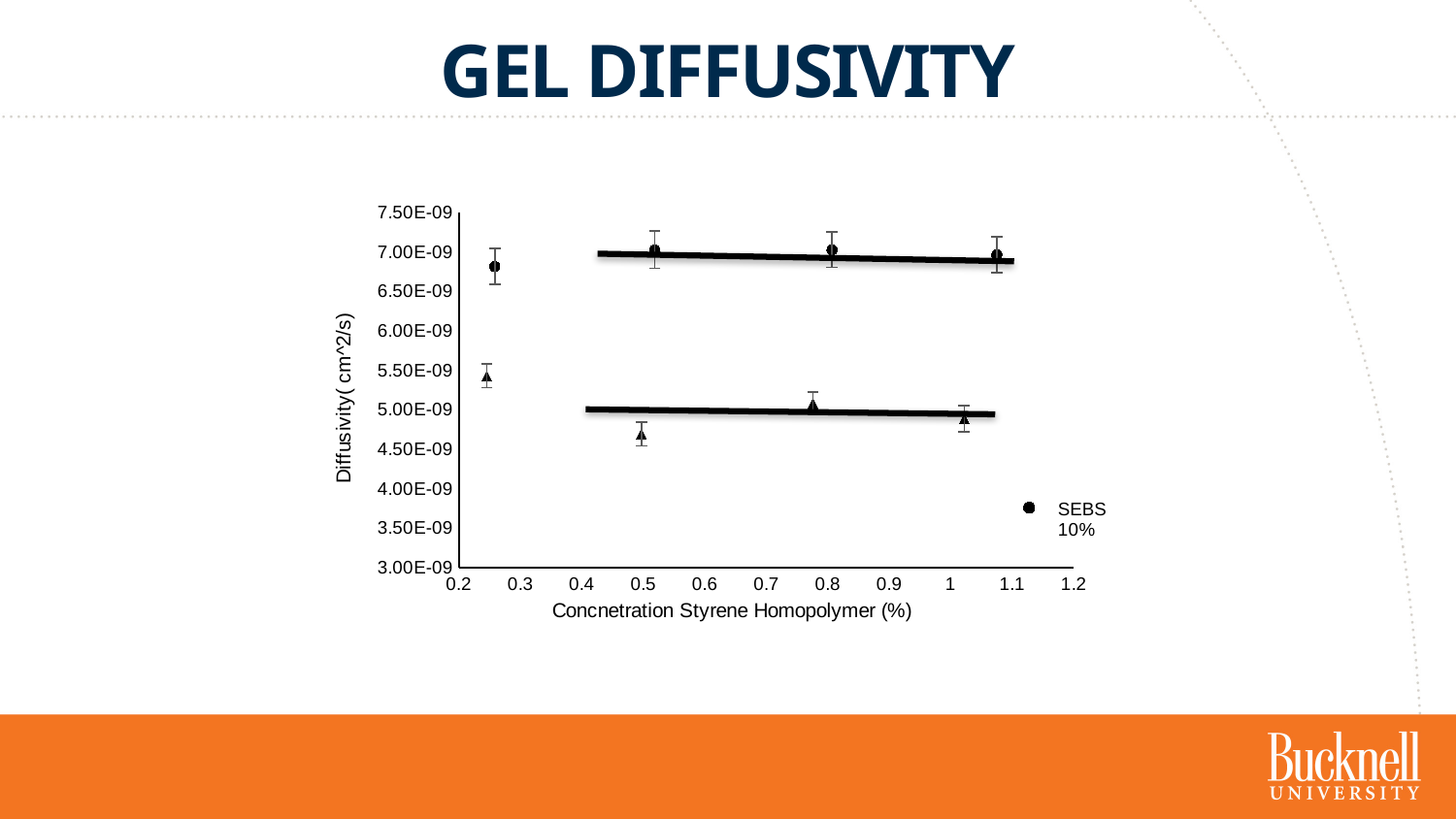
Which series has higher diffusivity values overall, the circle (SEBS 10%) series or the triangle series? SEBS 10% (circle) series What kind of chart is shown on the slide? scatter chart What is the highest tick value shown on the y-axis? 7.50E-09 How many triangle-marker data points are plotted? 4 Is the triangle-marker value at a concentration of about 0.5% greater or less than 5.00E-09? less Is the triangle-marker value at a concentration of about 0.25% greater or less than 5.00E-09? greater What series name does the legend list? SEBS 10% How many SEBS 10% (circle) data points are plotted? 4 Is the SEBS 10% value at a concentration of about 0.5% greater or less than 6.50E-09? greater What is the x-axis title of the chart? Concnetration Styrene Homopolymer (%) Which series contains the lowest plotted diffusivity value? the triangle series